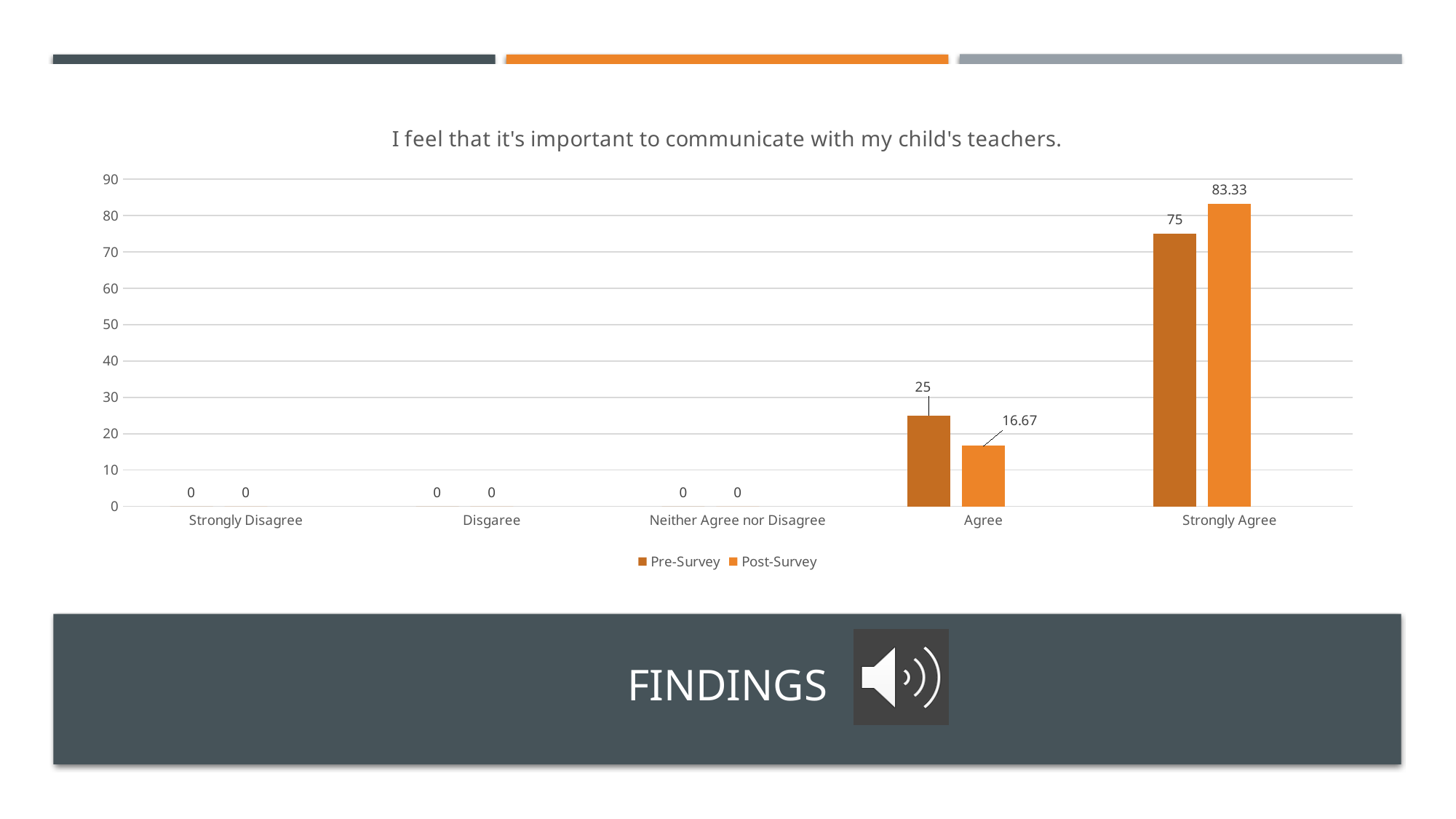
What kind of chart is shown on the slide? Bar chart What is the Pre-Survey value for Strongly Disagree? 0 What is the Post-Survey value for Strongly Agree? 83.33 Which is larger for Agree, the Pre-Survey value or the Post-Survey value? Pre-Survey How many series does the legend list? 2 What is the Pre-Survey value for Agree? 25 How many categories are shown on the x axis? 5 What is the title of the chart? I feel that it's important to communicate with my child's teachers. What is the difference between the Pre-Survey and Post-Survey values for Strongly Agree? 8.33 Which category has the highest Post-Survey value? Strongly Agree What is the Post-Survey value for Agree? 16.67 What is the difference between the Pre-Survey and Post-Survey values for Agree? 8.33